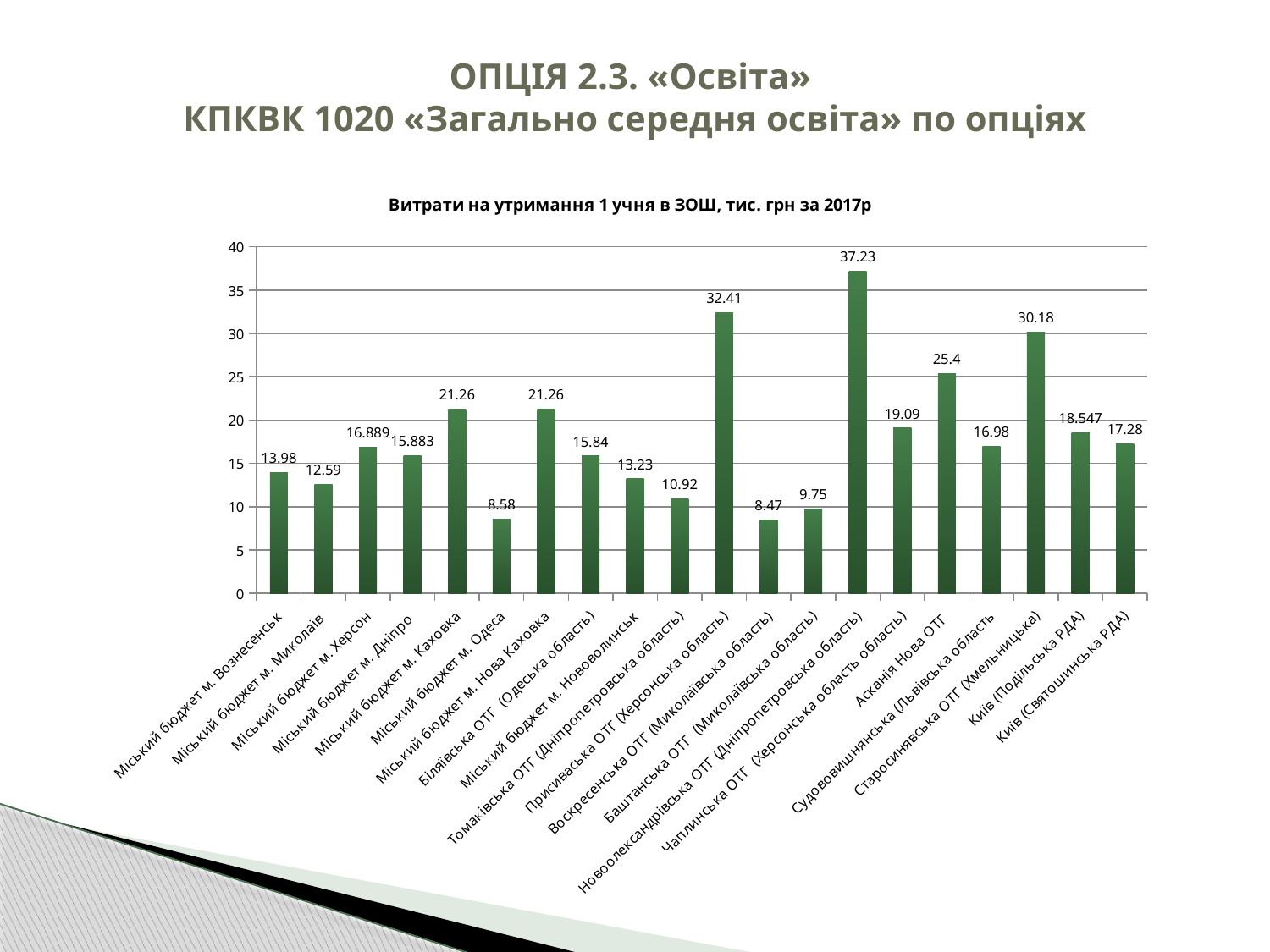
Which category has the lowest value? Воскресенська ОТГ (Миколаївська область) What is the difference between the values for Асканія Нова ОТГ and Чаплинська ОТГ (Херсонська область)? 6.31 What is the difference between the values for Новоолександрівська ОТГ (Дніпропетровська область) and Присиваська ОТГ (Херсонська область)? 4.82 How many categories (bars) are plotted in the chart? 20 What type of chart is shown on the slide? Bar chart What is the value for Новоолександрівська ОТГ (Дніпропетровська область)? 37.23 Which category has the highest value? Новоолександрівська ОТГ (Дніпропетровська область) What is the value for Київ (Подільська РДА)? 18.547 Which is larger: the value for Старосинявська ОТГ (Хмельницька) or the value for Асканія Нова ОТГ? Старосинявська ОТГ (Хмельницька) What is the value for Міський бюджет м. Херсон? 16.889 What is the title of the chart? Витрати на утримання 1 учня в ЗОШ, тис. грн за 2017р Is the value for Міський бюджет м. Одеса greater or less than 10? less